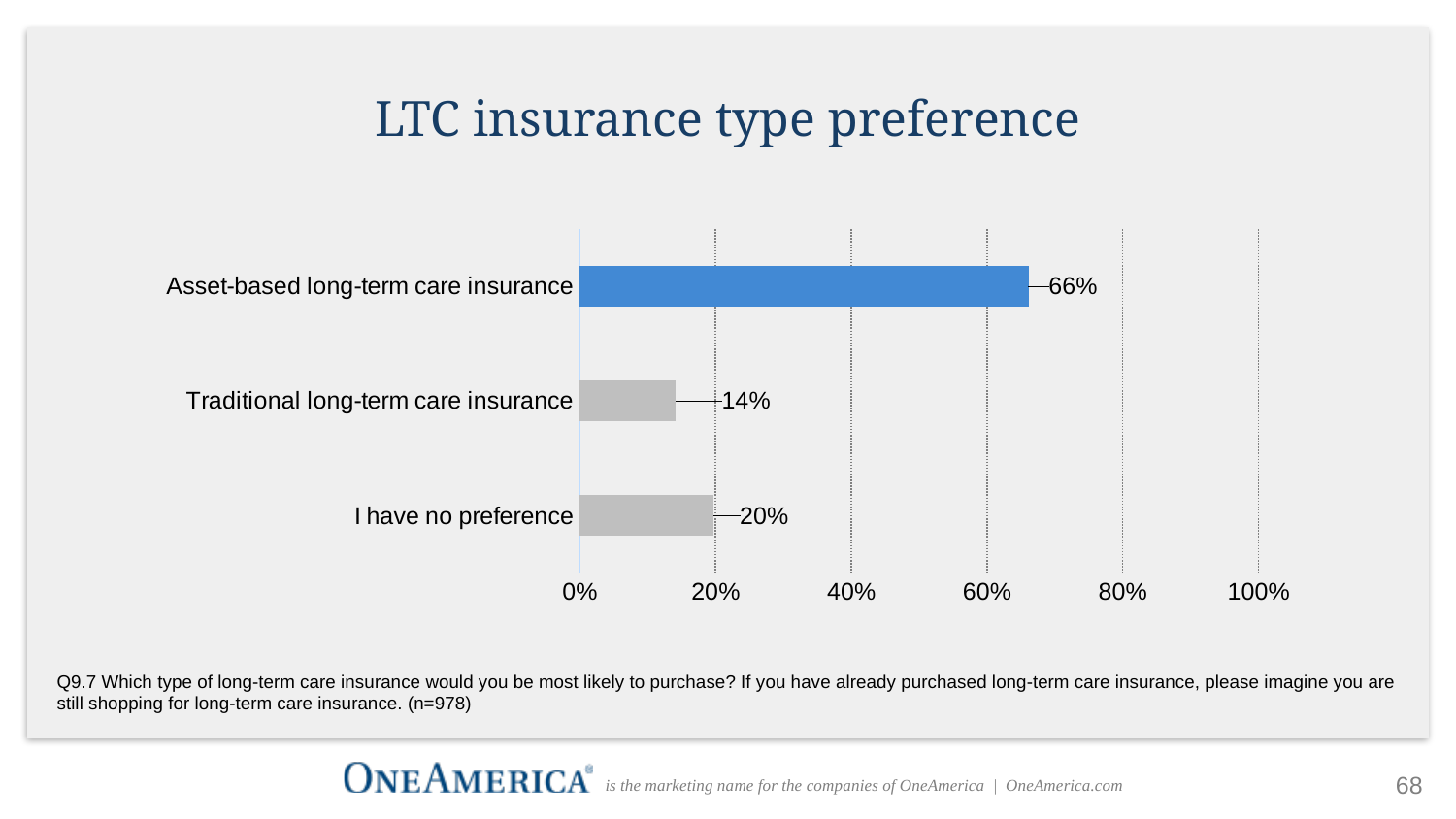
What kind of chart is shown on the slide? Bar chart How many categories are shown in the chart? 3 What is the title of the chart? LTC insurance type preference What percentage of respondents prefer traditional long-term care insurance? 14% What is the difference between the values for 'I have no preference' and traditional long-term care insurance? 6% Is the value for asset-based long-term care insurance greater or less than 60%? greater Which category has the lowest value? Traditional long-term care insurance Which is larger: the value for 'I have no preference' or the value for traditional long-term care insurance? I have no preference Which category has the highest value? Asset-based long-term care insurance What is the difference between the values for asset-based long-term care insurance and traditional long-term care insurance? 52% What percentage of respondents said they have no preference? 20% What percentage of respondents prefer asset-based long-term care insurance? 66%